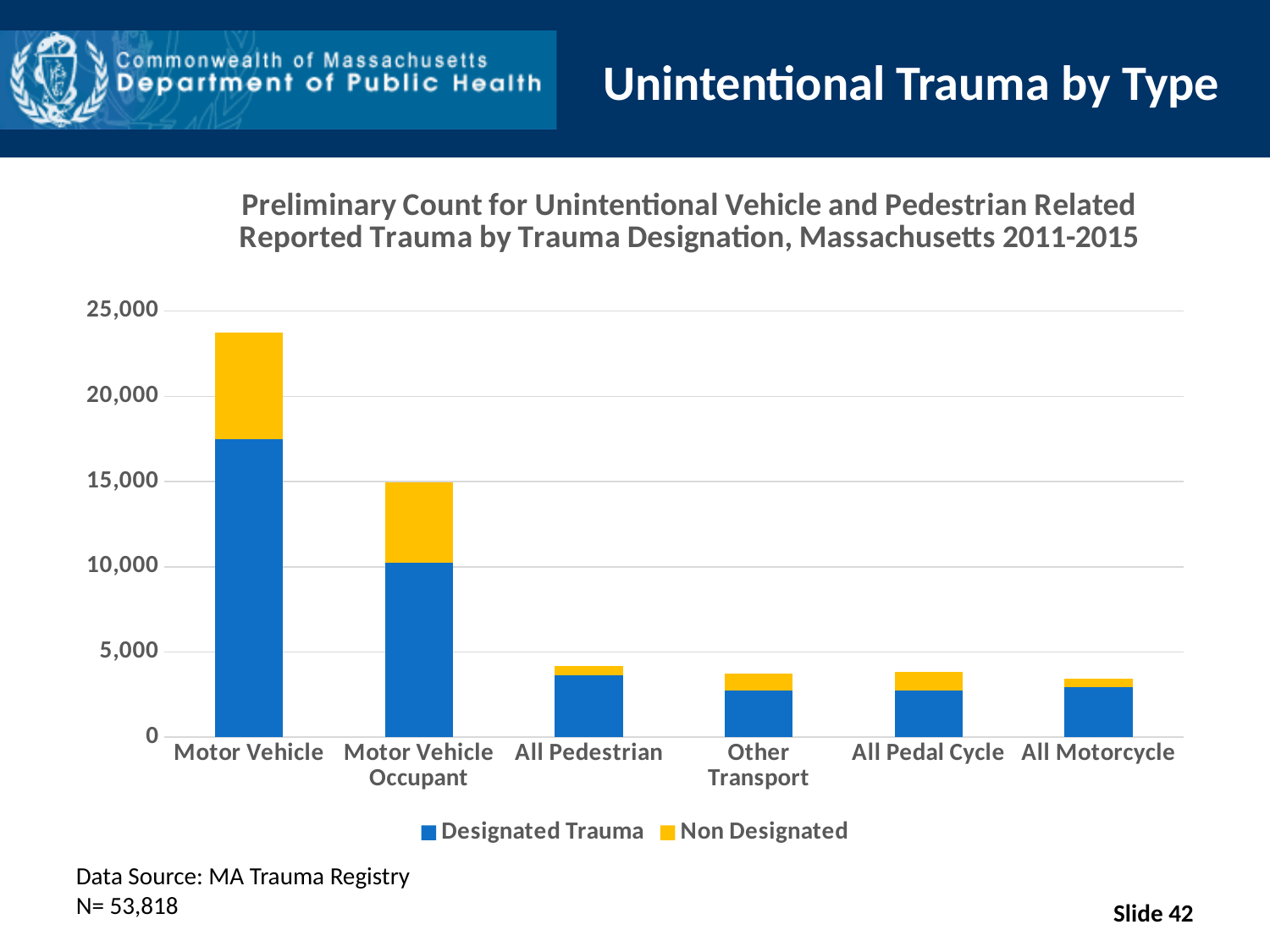
Is the total value for All Pedestrian greater or less than 5,000? less How many categories are shown on the x axis? 6 What kind of chart is shown on the slide? bar chart Is the total value for Motor Vehicle greater or less than 20,000? greater Is the Designated Trauma value for Motor Vehicle greater or less than 15,000? greater Which category has the highest total bar? Motor Vehicle Which is larger, the total bar for All Pedestrian or for All Motorcycle? All Pedestrian Which is larger, the total bar for Motor Vehicle or for Motor Vehicle Occupant? Motor Vehicle What are the two series named in the legend? Designated Trauma and Non Designated How many series does the legend list? 2 What colour represents the Non Designated series? yellow